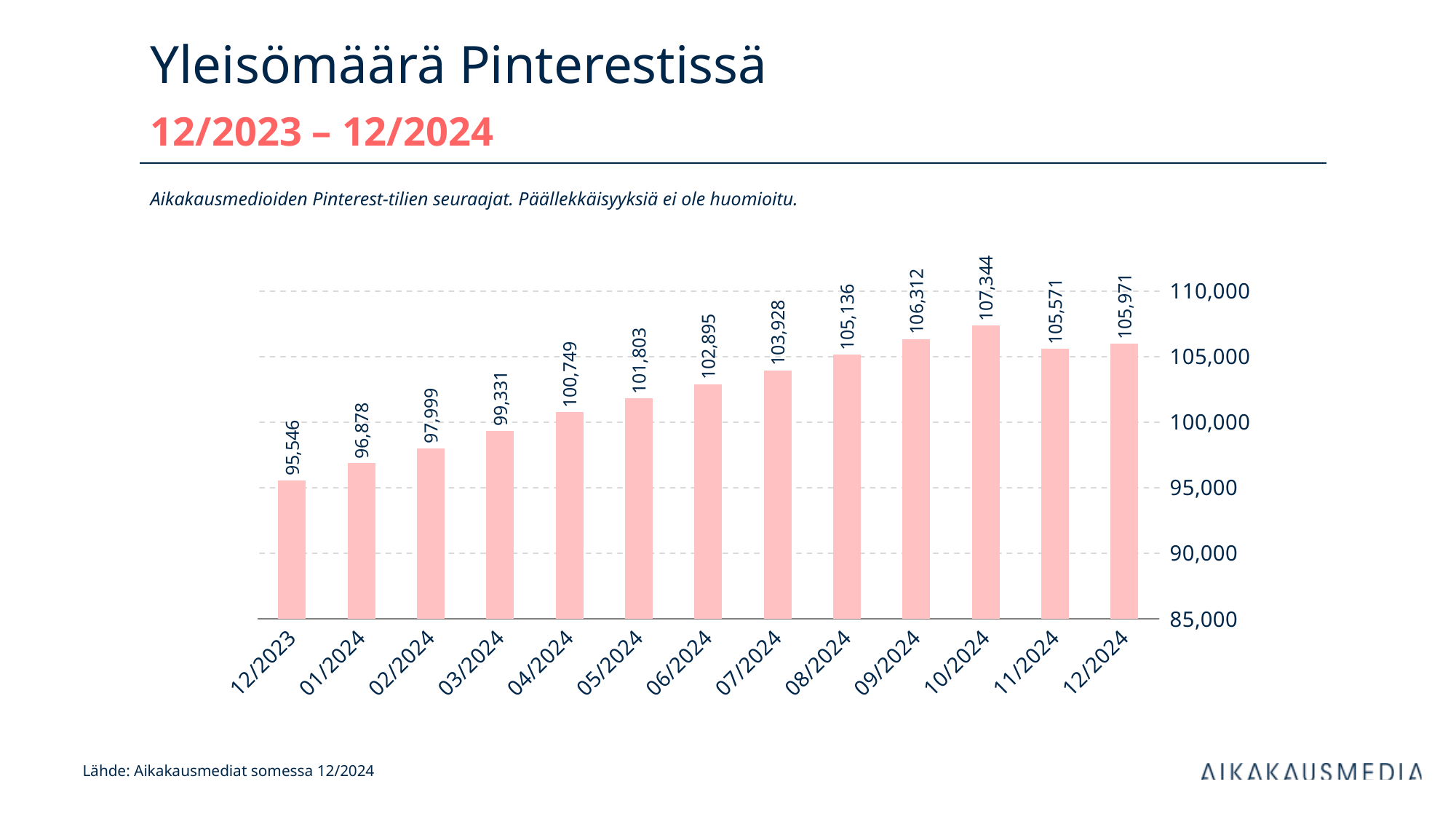
Which month has the lowest value? 12/2023 What is the difference between the values for 10/2024 and 11/2024? 1,773 How many months are shown on the x axis? 13 What is the value for 12/2023? 95,546 What is the value for 06/2024? 102,895 What is the value for 12/2024? 105,971 What is the difference between the values for 12/2024 and 12/2023? 10,425 What kind of chart is shown on the slide? bar chart Which month has the highest value? 10/2024 Do the values rise or fall from 12/2023 to 10/2024? rise Which is larger, the value for 11/2024 or the value for 12/2024? 12/2024 Is the value for 03/2024 greater or less than 100,000? less